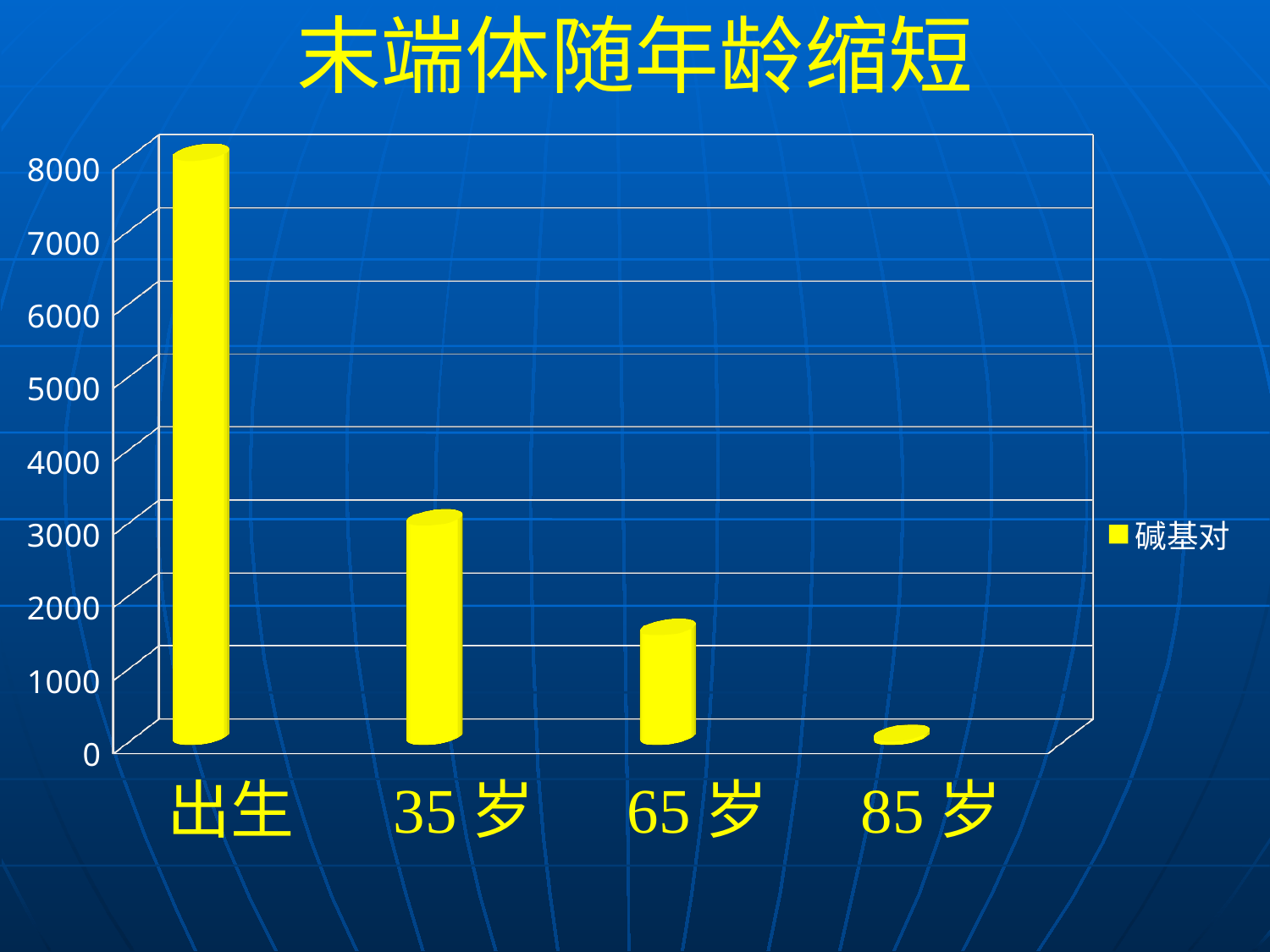
How many categories are shown on the x axis of the chart? 4 Do the values rise or fall from 出生 to 85 岁 along the x axis? fall What is the name of the series shown in the chart's legend? 碱基对 Is the value for 85 岁 greater or less than 1000? less Is the value for 35 岁 greater or less than 4000? less How many series does the chart's legend list? 1 What kind of chart is shown on the slide? bar chart Which category has the highest value in the chart? 出生 Which category has the lowest value in the chart? 85 岁 Is the value for 65 岁 greater or less than 1000? greater Which has the larger value, 35 岁 or 65 岁? 35 岁